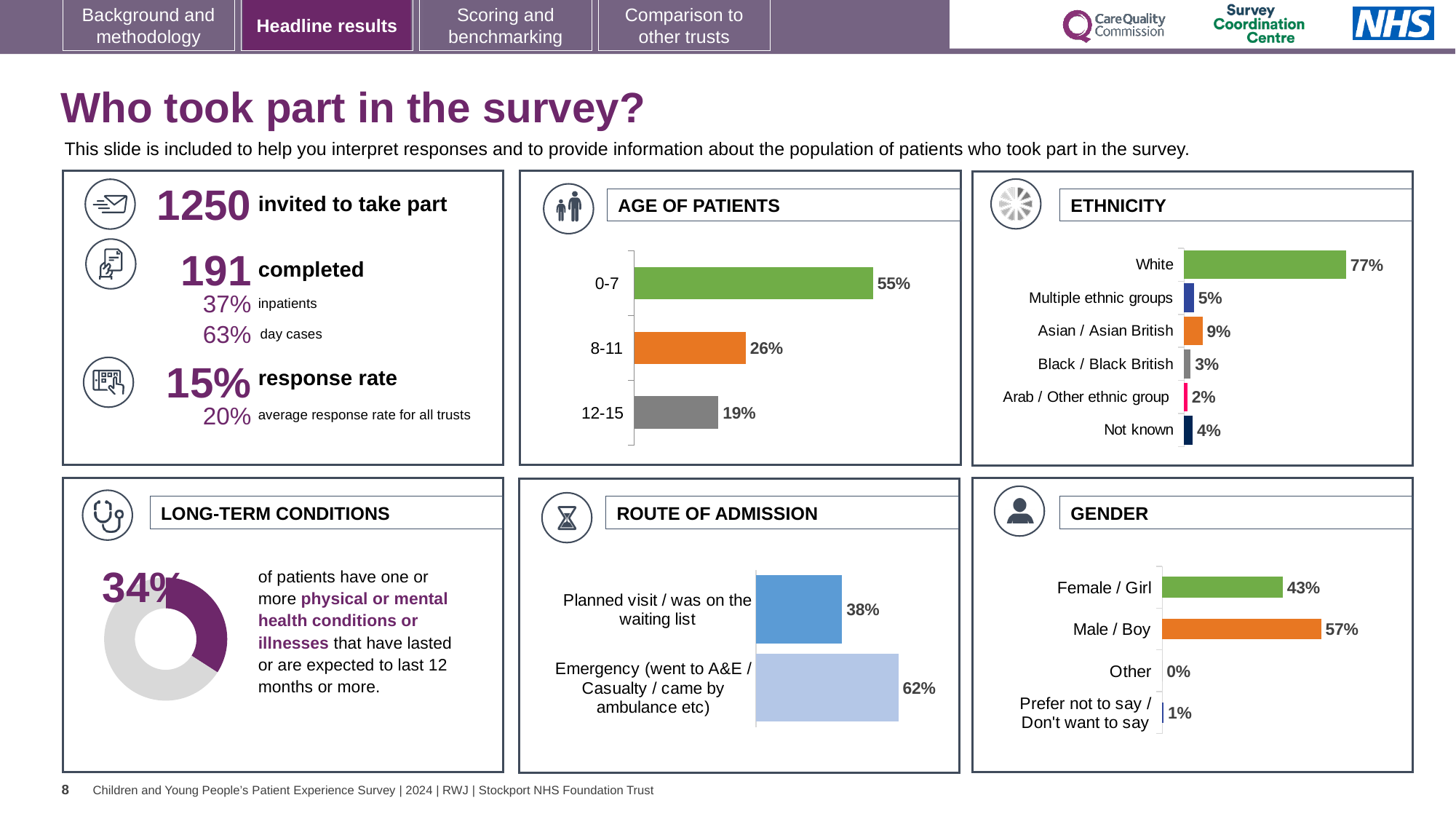
In the AGE OF PATIENTS chart, what percentage of patients were aged 0-7? 55% In the ETHNICITY chart, which is larger: Multiple ethnic groups or Not known? Multiple ethnic groups In the ROUTE OF ADMISSION chart, what is the difference between the Emergency and Planned visit percentages? 24% In the GENDER chart, what percentage of patients were Male / Boy? 57% In the AGE OF PATIENTS chart, what is the difference between the 0-7 and 8-11 percentages? 29% In the ETHNICITY chart, which category has the highest percentage? White In the AGE OF PATIENTS chart, which age group has the lowest percentage? 12-15 What kind of chart is the LONG-TERM CONDITIONS chart? Doughnut chart How many categories are shown in the ETHNICITY chart? 6 In the GENDER chart, which category has the highest percentage? Male / Boy In the ETHNICITY chart, what percentage of patients were Asian / Asian British? 9% In the ROUTE OF ADMISSION chart, what percentage of patients came as an emergency? 62%